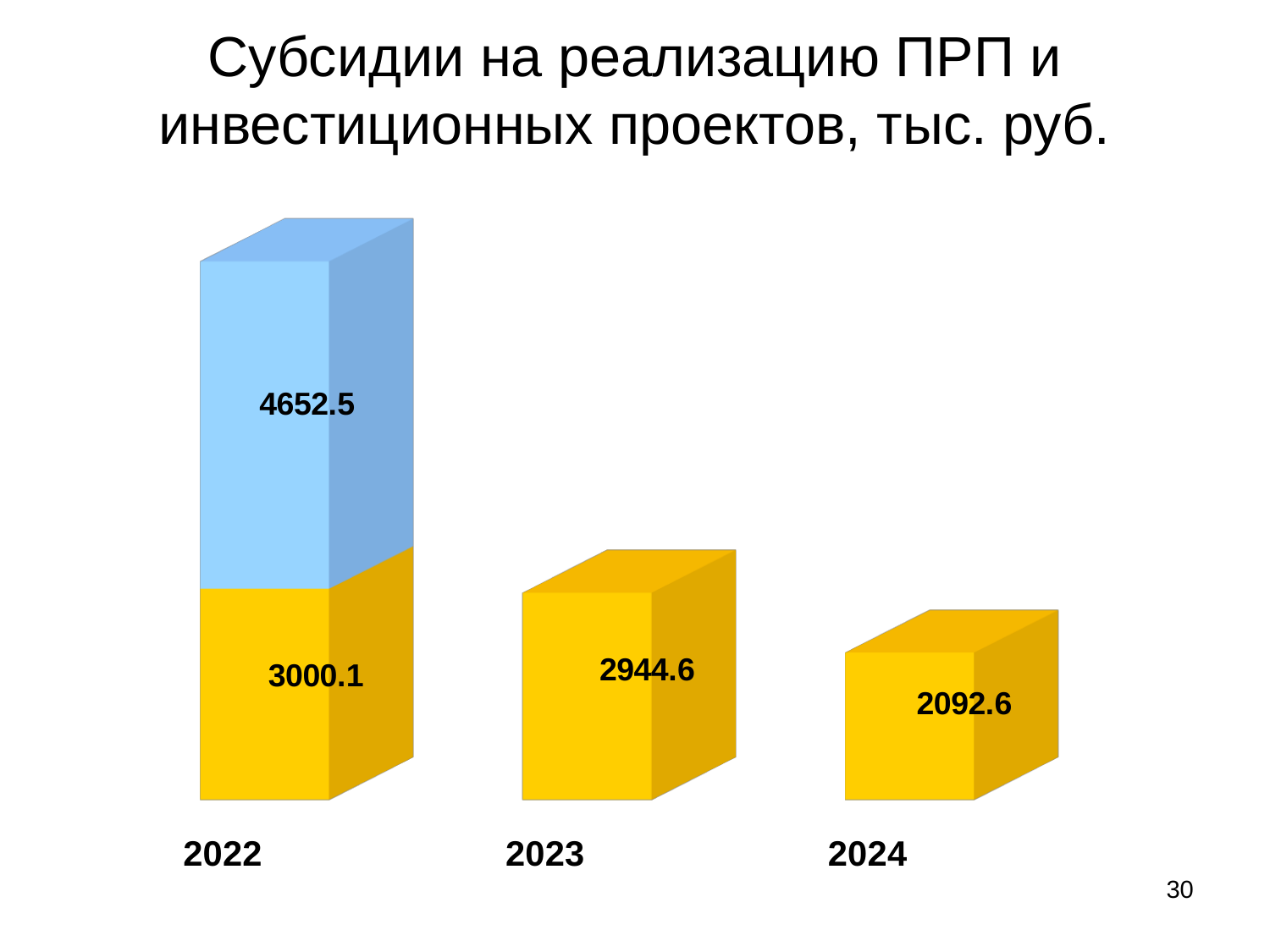
Which year has the highest yellow-segment value? 2022 Which year has the lowest yellow-segment value? 2024 Which is larger, the yellow segment for 2022 or the value for 2023? 2022 What is the difference between the 2023 value and the 2024 value? 852.0 What is the value of the yellow segment for 2022? 3000.1 What kind of chart is shown on the slide? Bar chart What is the value of the blue segment for 2022? 4652.5 What is the total of the stacked bar for 2022? 7652.6 What is the value shown for 2023? 2944.6 What is the difference between the blue and yellow segments for 2022? 1652.4 What is the value shown for 2024? 2092.6 How many years are shown on the x axis? 3